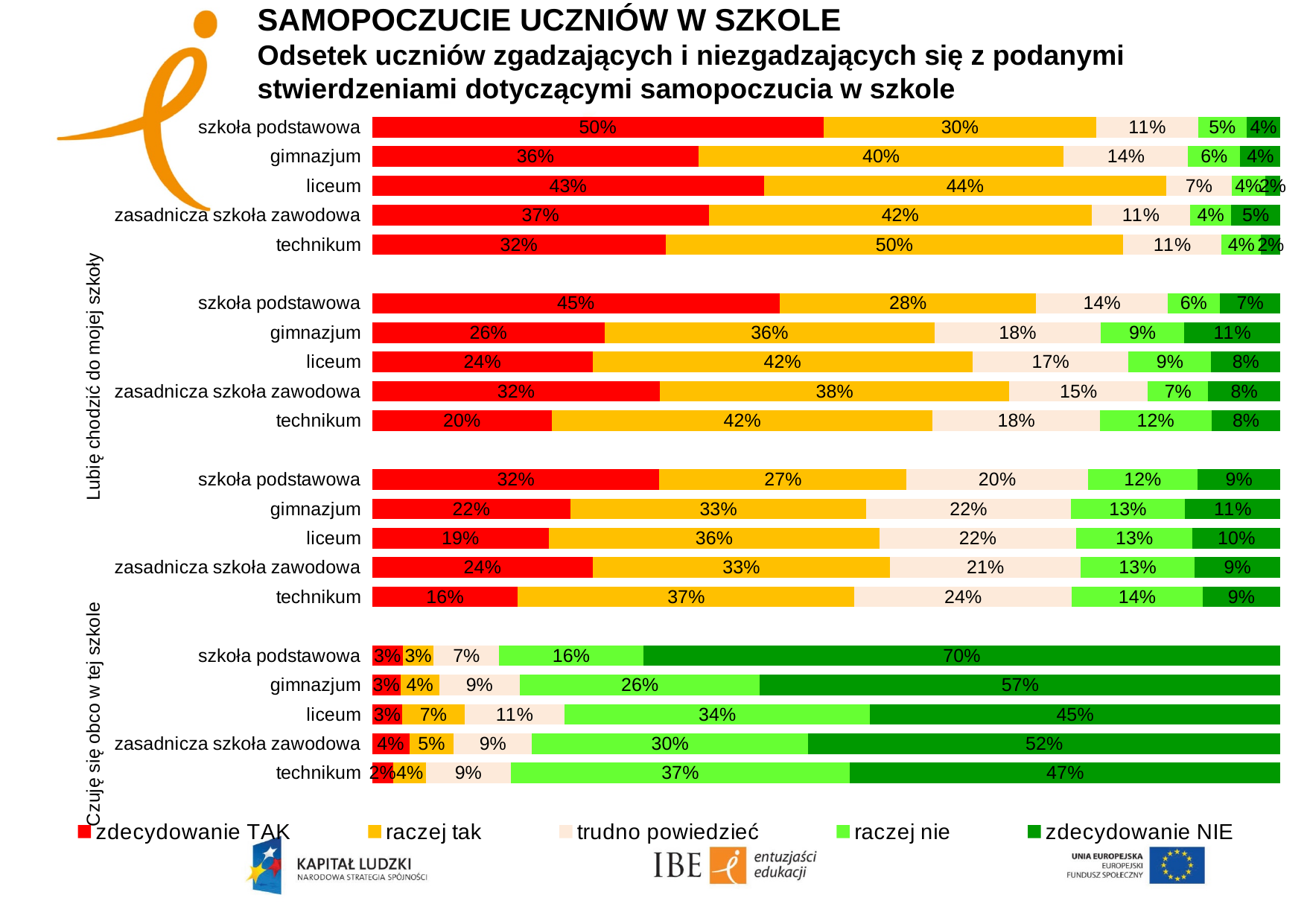
In the bottom group of bars (Czuję się obco w tej szkole), what is the 'zdecydowanie NIE' value for szkoła podstawowa? 70% In the bottom group of bars (Czuję się obco w tej szkole), which school type has the highest 'zdecydowanie NIE' value? szkoła podstawowa In the second group of bars from the top, what is the 'zdecydowanie NIE' value for gimnazjum? 11% What kind of chart is shown on the slide? stacked bar chart In the top group of bars, what is the difference between the 'zdecydowanie TAK' values for szkoła podstawowa and technikum? 18 percentage points In the bottom group of bars (Czuję się obco w tej szkole), which school type has the lowest 'zdecydowanie NIE' value? liceum How many school types are listed in each group of bars? 5 In the second group of bars from the top, which has the larger 'raczej tak' value: liceum or gimnazjum? liceum How many series does the legend list? 5 In the third group of bars from the top, what is the 'trudno powiedzieć' value for technikum? 24% What is the total of the top bar (szkoła podstawowa in the first group) across all five segments? 100% In the top group of bars, what is the 'zdecydowanie TAK' value for szkoła podstawowa? 50%